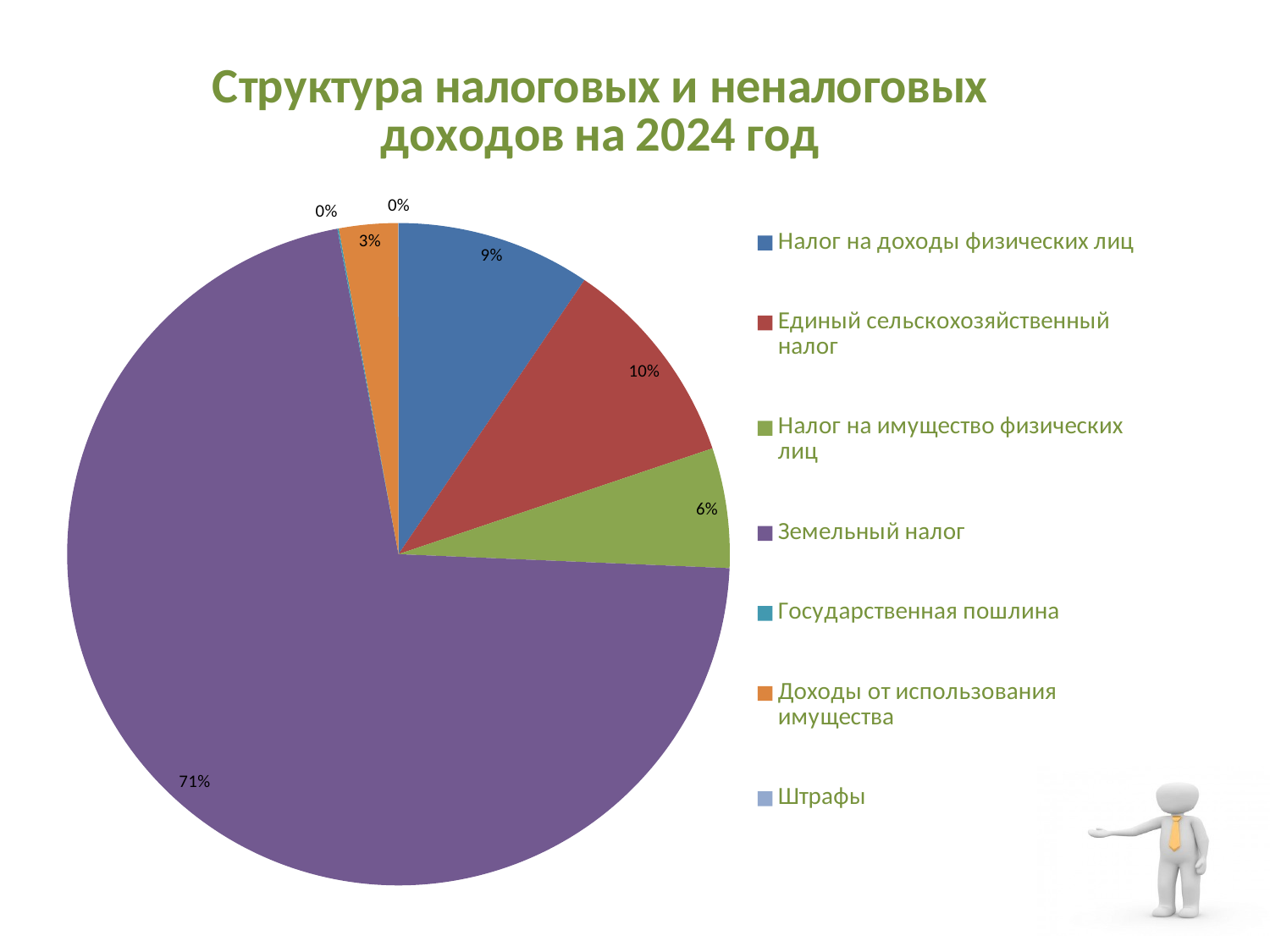
How many categories does the legend list? 7 What colour is the slice for Земельный налог? Purple What is the title of the chart? Структура налоговых и неналоговых доходов на 2024 год What percentage is shown for Налог на имущество физических лиц? 6% What share of the pie does Земельный налог account for? 71% What percentage is shown for Налог на доходы физических лиц? 9% What percentage is shown for Единый сельскохозяйственный налог? 10% What kind of chart is shown on the slide? Pie chart What is the difference in percentage points between Земельный налог and Единый сельскохозяйственный налог? 61 What percentage is shown for Доходы от использования имущества? 3% Which is larger: the share for Единый сельскохозяйственный налог or the share for Налог на доходы физических лиц? Единый сельскохозяйственный налог Which category has the largest share of the pie? Земельный налог